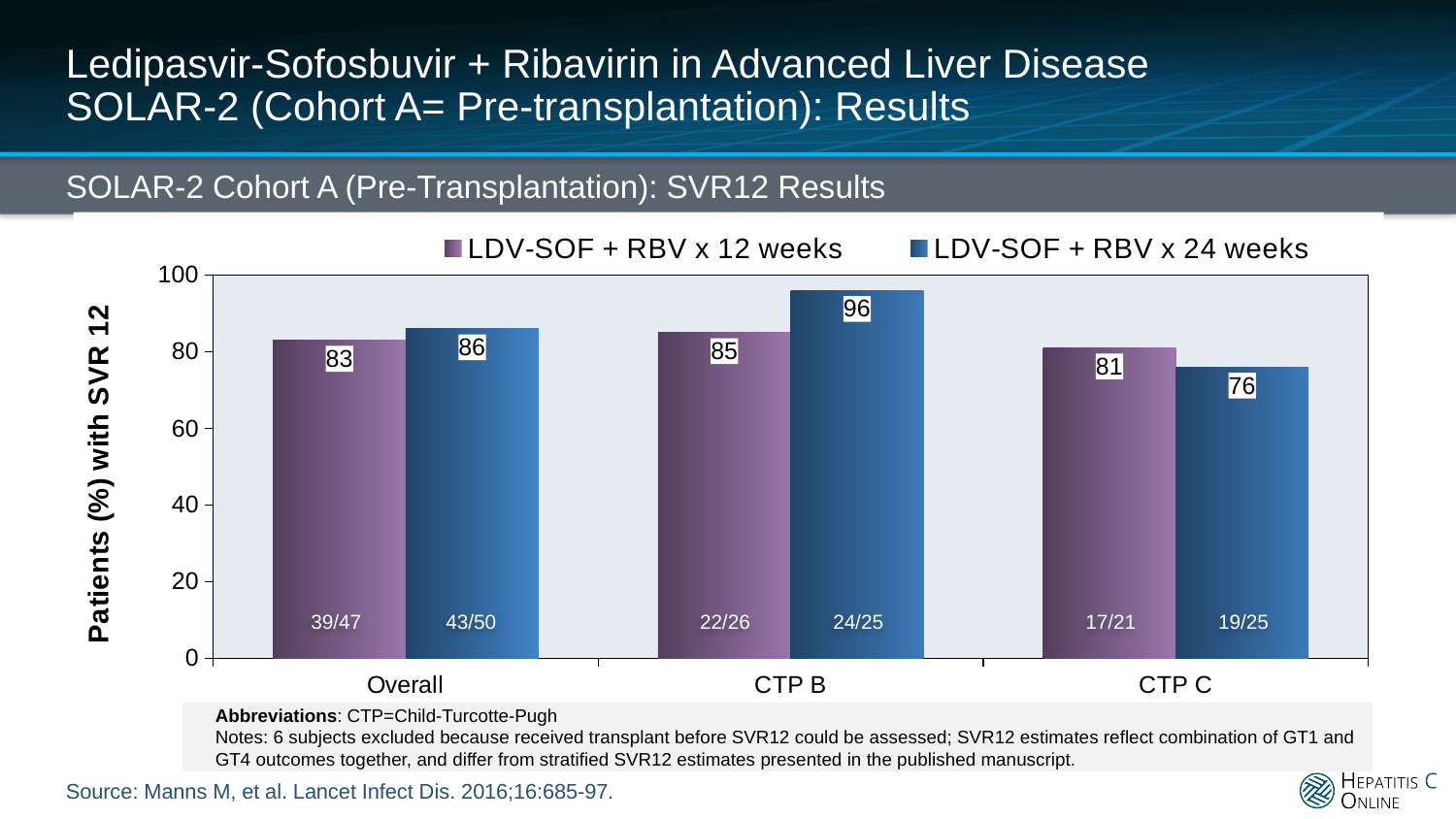
How many series does the legend list? 2 In the CTP C group, which regimen has the higher SVR12 rate, 12 weeks or 24 weeks? LDV-SOF + RBV x 12 weeks What fraction of patients is shown for LDV-SOF + RBV x 12 weeks in the CTP B group? 22/26 What kind of chart is shown on the slide? Bar chart Which category has the lowest SVR12 rate for LDV-SOF + RBV x 24 weeks? CTP C What is the SVR12 rate for LDV-SOF + RBV x 12 weeks in the Overall group? 83 What is the SVR12 rate for LDV-SOF + RBV x 24 weeks in the CTP C group? 76 How many categories are shown on the x axis? 3 What is the SVR12 rate for LDV-SOF + RBV x 24 weeks in the CTP B group? 96 Which category has the highest SVR12 rate for LDV-SOF + RBV x 24 weeks? CTP B What is the difference between the 24-week and 12-week SVR12 rates in the CTP B group? 11 What is the label of the y axis? Patients (%) with SVR 12